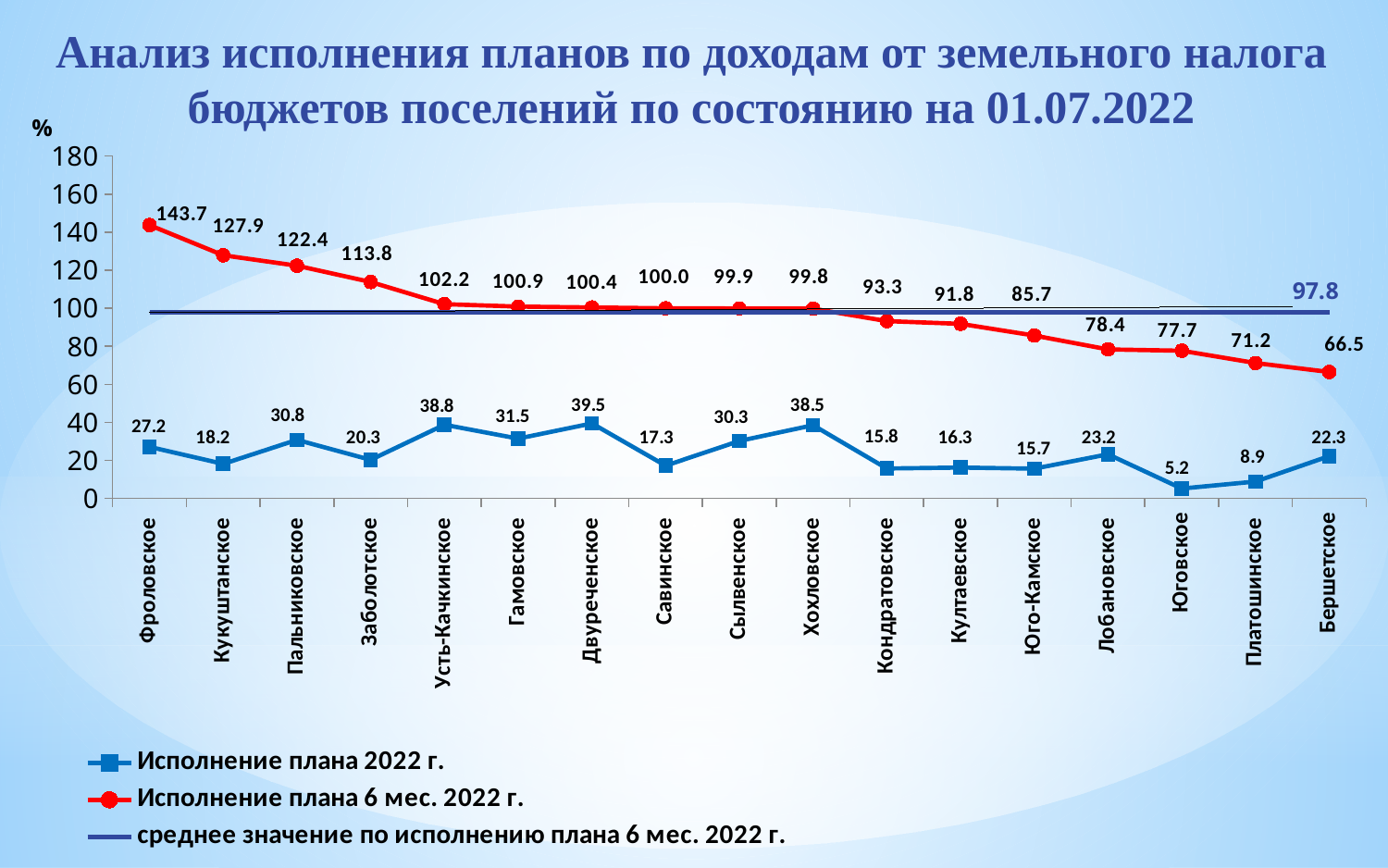
Does the 'Исполнение плана 6 мес. 2022 г.' series rise or fall from left to right along the x axis? fall Which settlement has the highest value for 'Исполнение плана 2022 г.'? Двуреченское Which settlement has the lowest value for 'Исполнение плана 6 мес. 2022 г.'? Бершетское How many series does the legend list? 3 What is the difference between the 'Исполнение плана 6 мес. 2022 г.' values for Фроловское and Бершетское? 77.2 What is the value of 'Исполнение плана 2022 г.' for Двуреченское? 39.5 What is the value of 'Исполнение плана 6 мес. 2022 г.' for Фроловское? 143.7 What is the value of the average line 'среднее значение по исполнению плана 6 мес. 2022 г.'? 97.8 Which is larger: the 'Исполнение плана 2022 г.' value for Усть-Качкинское or for Гамовское? Усть-Качкинское What type of chart is shown on the slide? line chart Which settlement has the lowest value for 'Исполнение плана 2022 г.'? Юговское How many settlements (categories) are shown on the x axis? 17